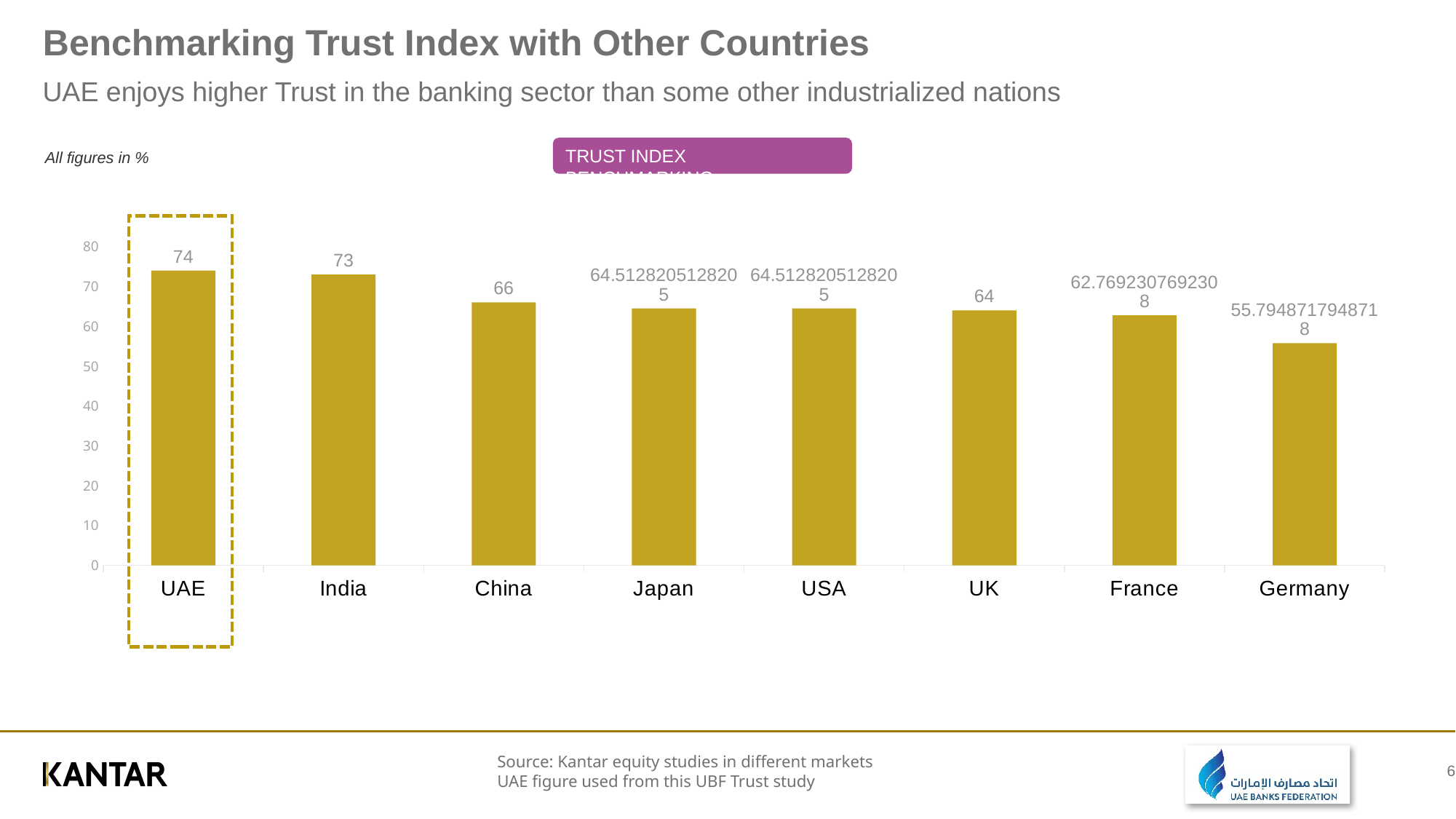
What is the Trust Index value for UK? 64 What is the difference between the Trust Index values for UAE and UK? 10 Which country's bar is highlighted with a dashed outline? UAE What is the Trust Index value for UAE? 74 What is the Trust Index value for China? 66 What kind of chart is shown on the slide? Bar chart What is the Trust Index value for India? 73 How many countries are shown in the chart? 8 Is the value for Germany greater or less than 60? less Which has a higher Trust Index value, China or UK? China Which country has the lowest Trust Index value? Germany Which country has the highest Trust Index value? UAE